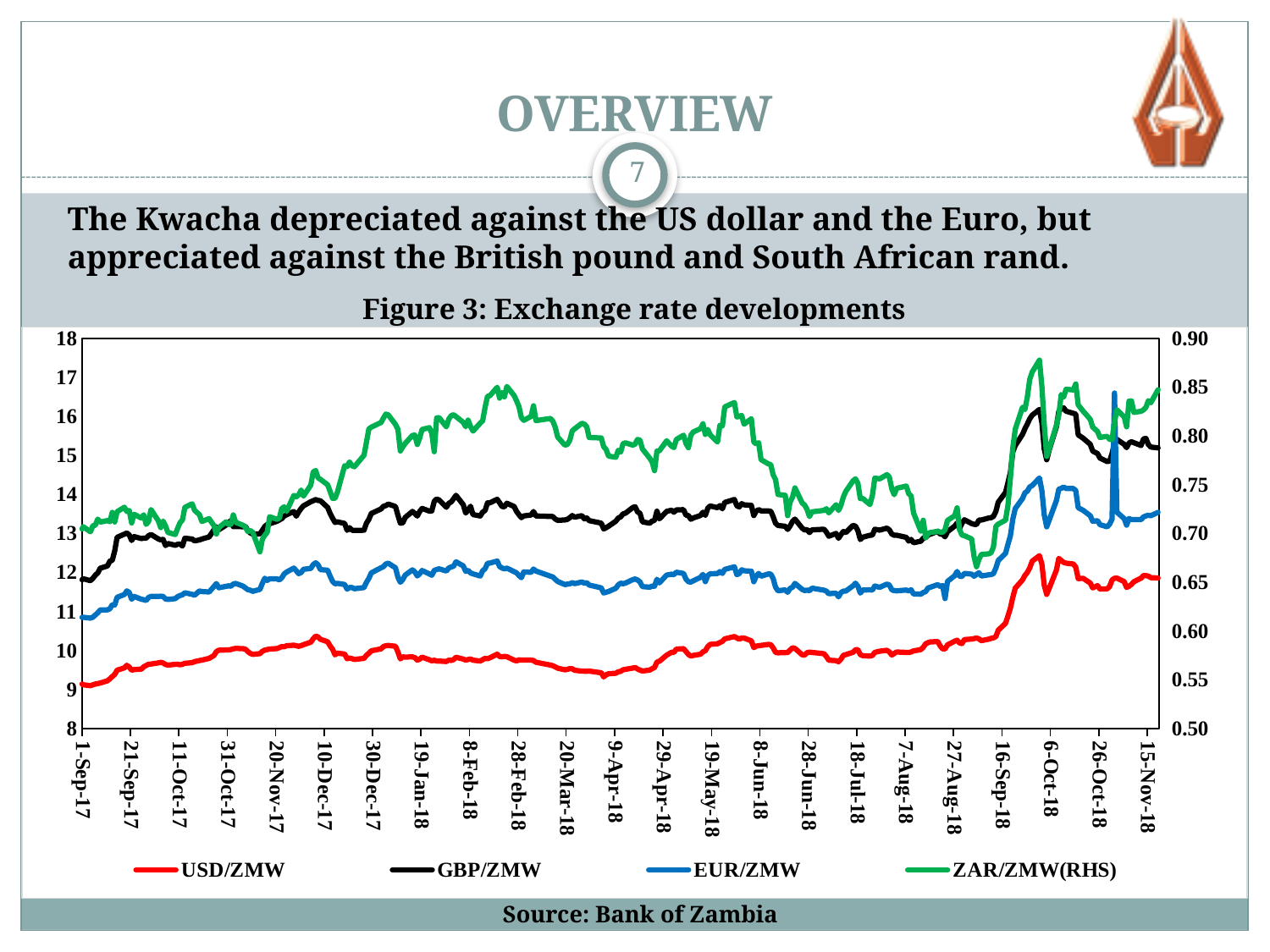
Is the EUR/ZMW value at 1-Sep-17 greater or less than 12? less Is the GBP/ZMW value at 1-Sep-17 greater or less than 13? less Does the USD/ZMW series rise or fall overall from 1-Sep-17 to 15-Nov-18? rise At 1-Sep-17, which is higher on the left axis, GBP/ZMW or EUR/ZMW? GBP/ZMW Is the USD/ZMW value at 1-Sep-17 greater or less than 10? less What kind of chart is shown in Figure 3? line chart How many series does the legend of the chart list? 4 Which of the series plotted on the left axis has the lowest values throughout the period? USD/ZMW Which series in the chart is plotted against the right-hand axis? ZAR/ZMW(RHS) What is the title of the chart on the slide? Figure 3: Exchange rate developments